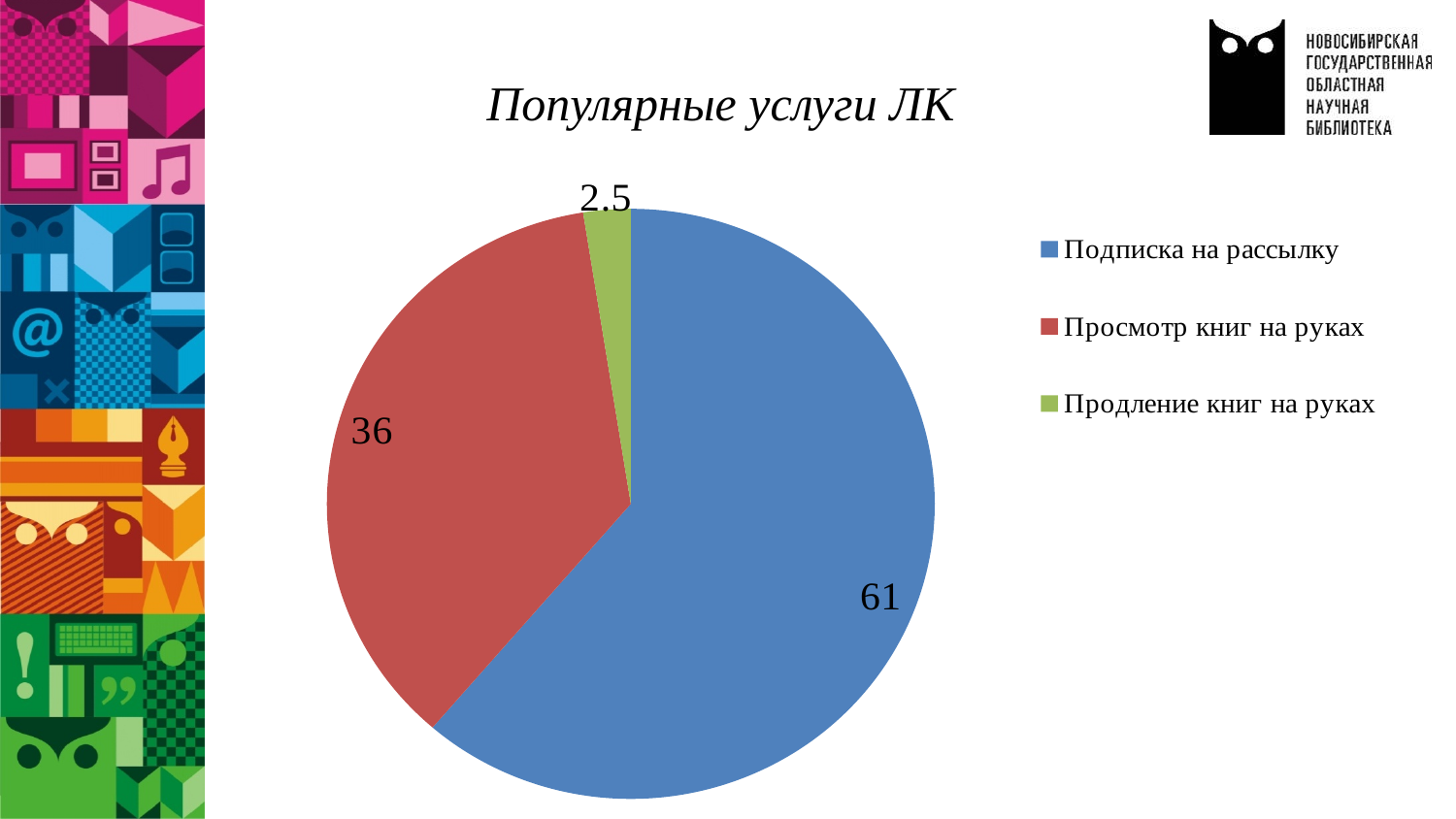
Which is larger, the value for Просмотр книг на руках or the value for Продление книг на руках? Просмотр книг на руках What is the difference between the values for Подписка на рассылку and Просмотр книг на руках? 25 What is the title of the chart? Популярные услуги ЛК What is the difference between the values for Просмотр книг на руках and Продление книг на руках? 33.5 What is the value for Подписка на рассылку? 61 What colour is the slice for Продление книг на руках? Green Which category has the smallest slice? Продление книг на руках Which category has the largest slice? Подписка на рассылку What is the value for Продление книг на руках? 2.5 What kind of chart is shown on the slide? Pie chart What is the value for Просмотр книг на руках? 36 How many categories does the pie chart have? 3